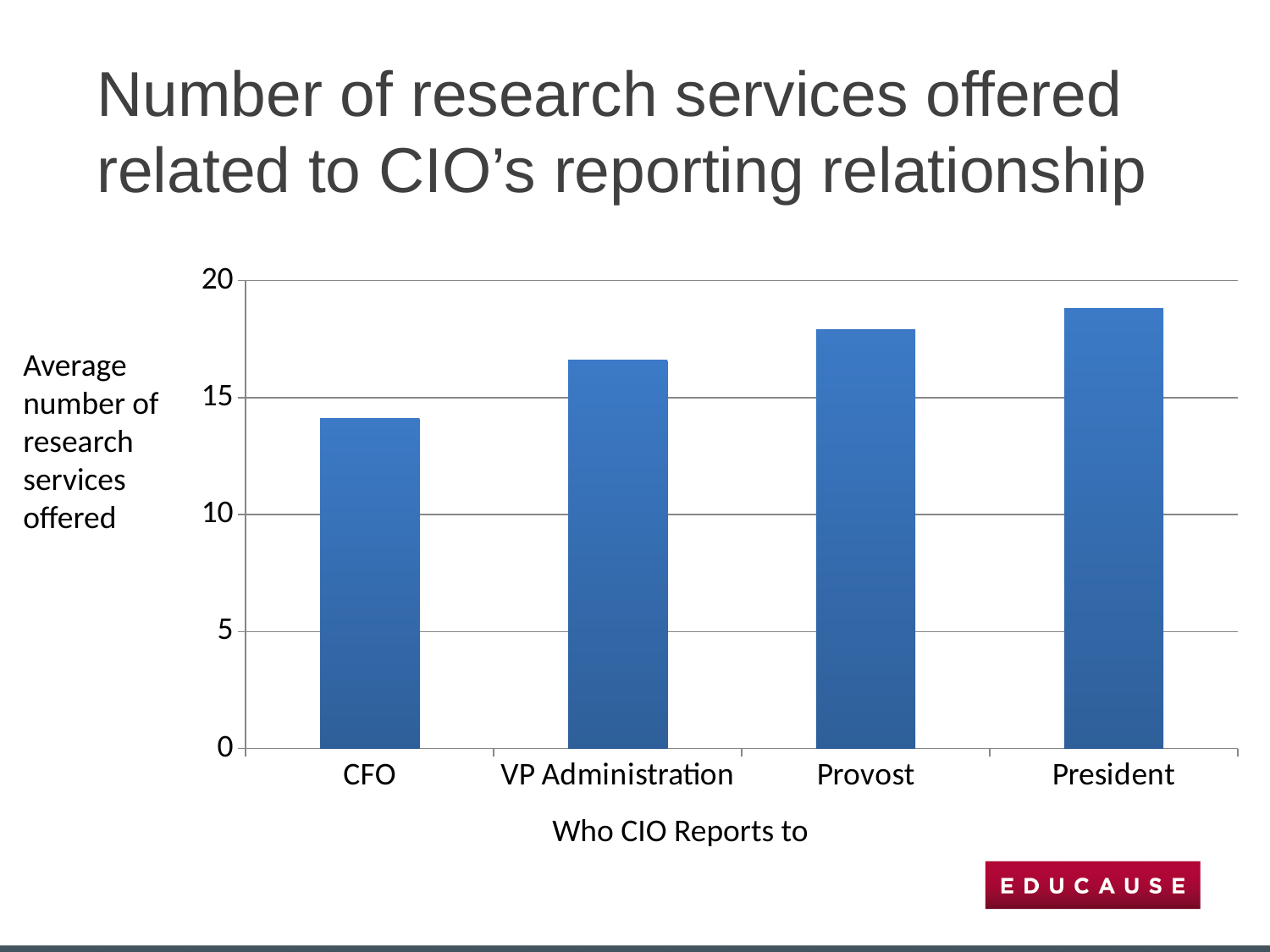
Which reporting relationship has the highest average number of research services offered? President Is the value for Provost greater or less than 20? less Do the values rise or fall moving from CFO to President along the x axis? rise Which is larger, the value for Provost or the value for CFO? Provost Is the value for CFO greater or less than 15? less Is the value for President greater or less than 15? greater What is the title of the x axis of the chart? Who CIO Reports to How many categories are shown on the x axis of the chart? 4 What kind of chart is shown on the slide? bar chart Which reporting relationship has the lowest average number of research services offered? CFO Which is larger, the value for VP Administration or the value for President? President